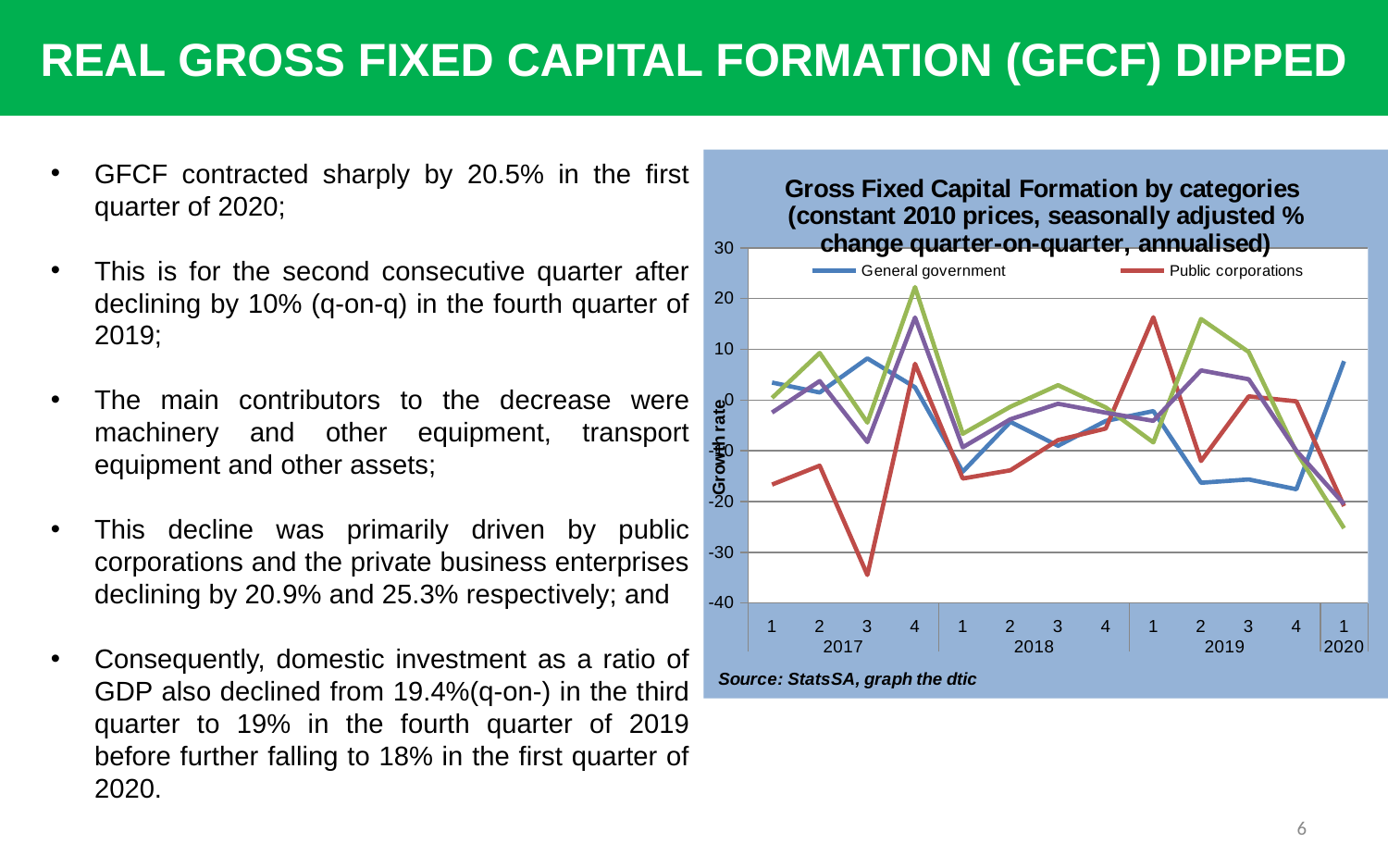
Does the Public corporations line rise or fall from quarter 3 of 2017 to quarter 4 of 2017? rise What is the label on the chart's vertical axis? Growth rate Is the value for Public corporations in quarter 3 of 2017 greater or less than -30? less How many quarterly points are plotted along the x axis of the chart? 13 Is the value for Public corporations in quarter 1 of 2019 greater or less than 10? greater In which quarter does the Public corporations line reach its lowest value? Quarter 3 of 2017 Is the value for General government in quarter 4 of 2019 greater or less than -10? less What kind of chart is shown on the slide? line chart In which quarter does the Public corporations line reach its highest value? Quarter 1 of 2019 How many series does the chart's legend list? 2 In quarter 1 of 2019, which is higher: General government or Public corporations? Public corporations